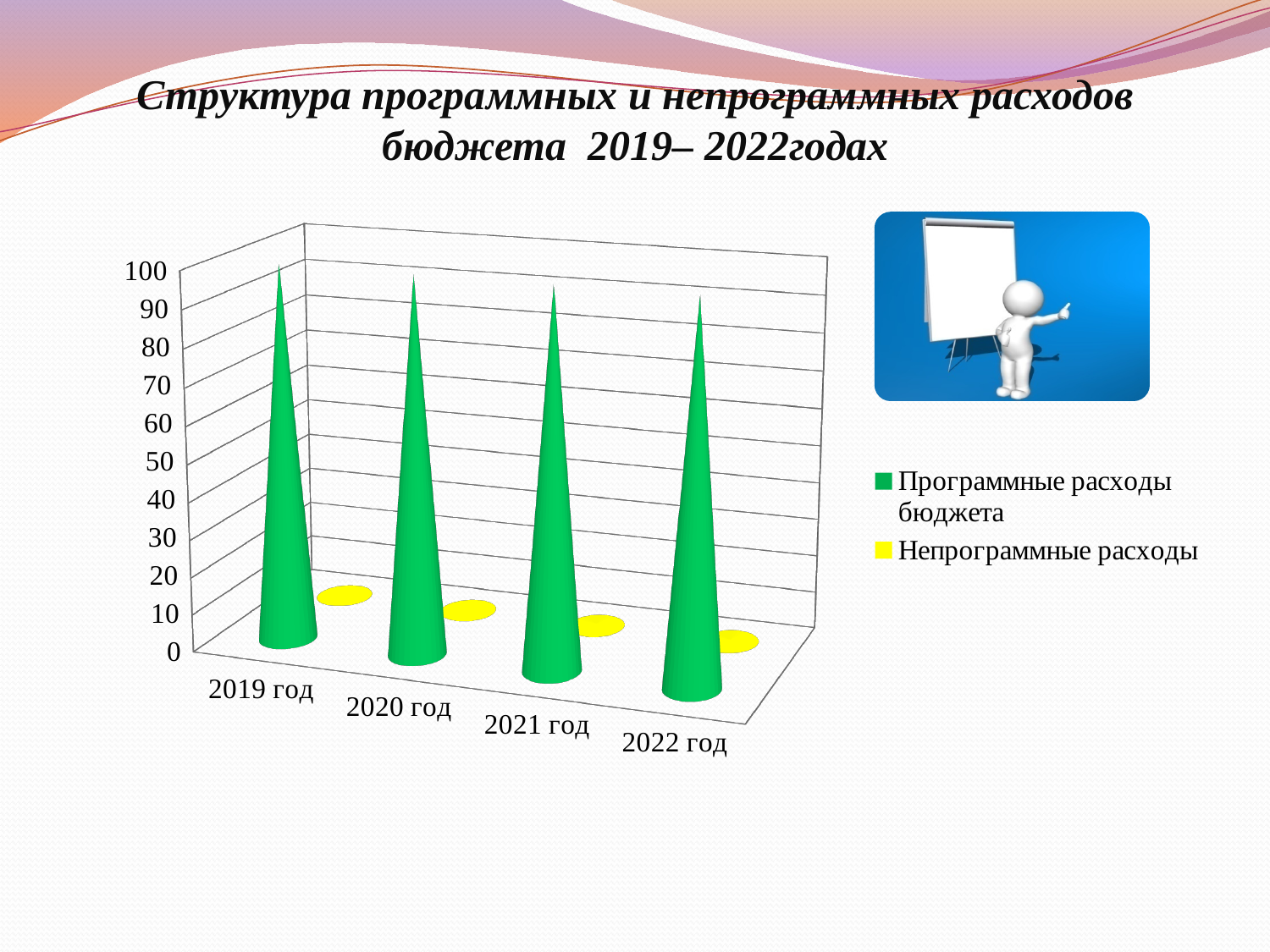
Which series is shown in green? Программные расходы бюджета How many year categories are shown on the x axis? 4 Is the value for Непрограммные расходы in 2022 год greater or less than 20? less Is the value for Программные расходы бюджета in 2019 год greater or less than 80? greater Which series is larger in 2022 год: Программные расходы бюджета or Непрограммные расходы? Программные расходы бюджета What is the first year category on the x axis? 2019 год How many series does the legend list? 2 Which series is larger in 2019 год: Программные расходы бюджета or Непрограммные расходы? Программные расходы бюджета What kind of chart is shown on the slide? bar chart Is the value for Программные расходы бюджета in 2021 год greater or less than 70? greater